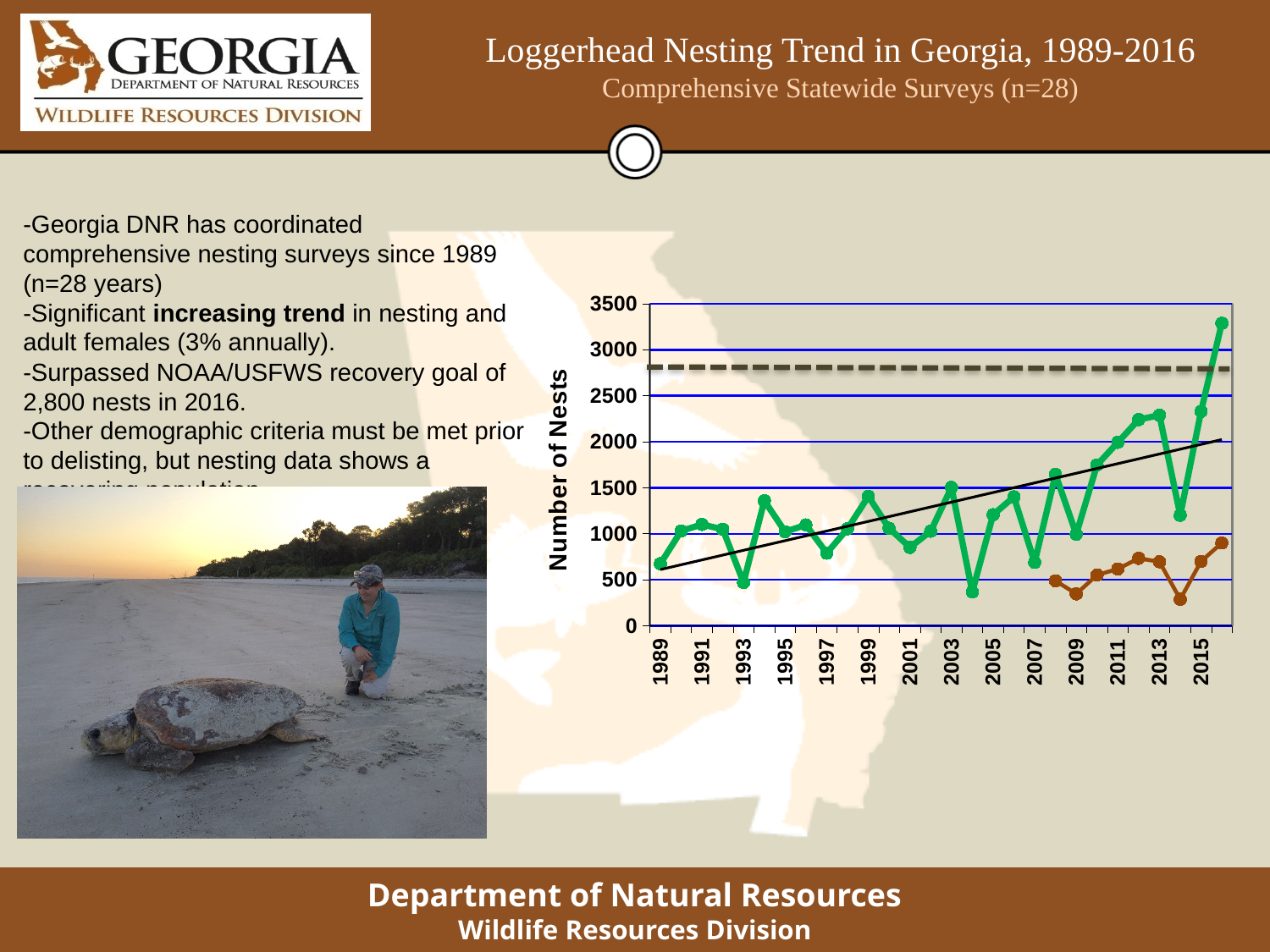
How many year labels are shown along the horizontal axis of the chart? 14 Which year has the larger value on the green line, 2012 or 2014? 2012 Is the green line's value for 2016 greater or less than 3000? greater What kind of chart is shown on the slide? line chart What is the highest value shown on the vertical axis of the chart? 3500 In which year does the green nest-count line reach its highest value? 2016 Is the green line's value for 2014 greater or less than 1500? less Is the horizontal dashed line on the chart greater or less than 2500? greater Overall, does the green nest-count line rise or fall from 1989 to 2016? rise What is the label on the vertical axis of the chart? Number of Nests